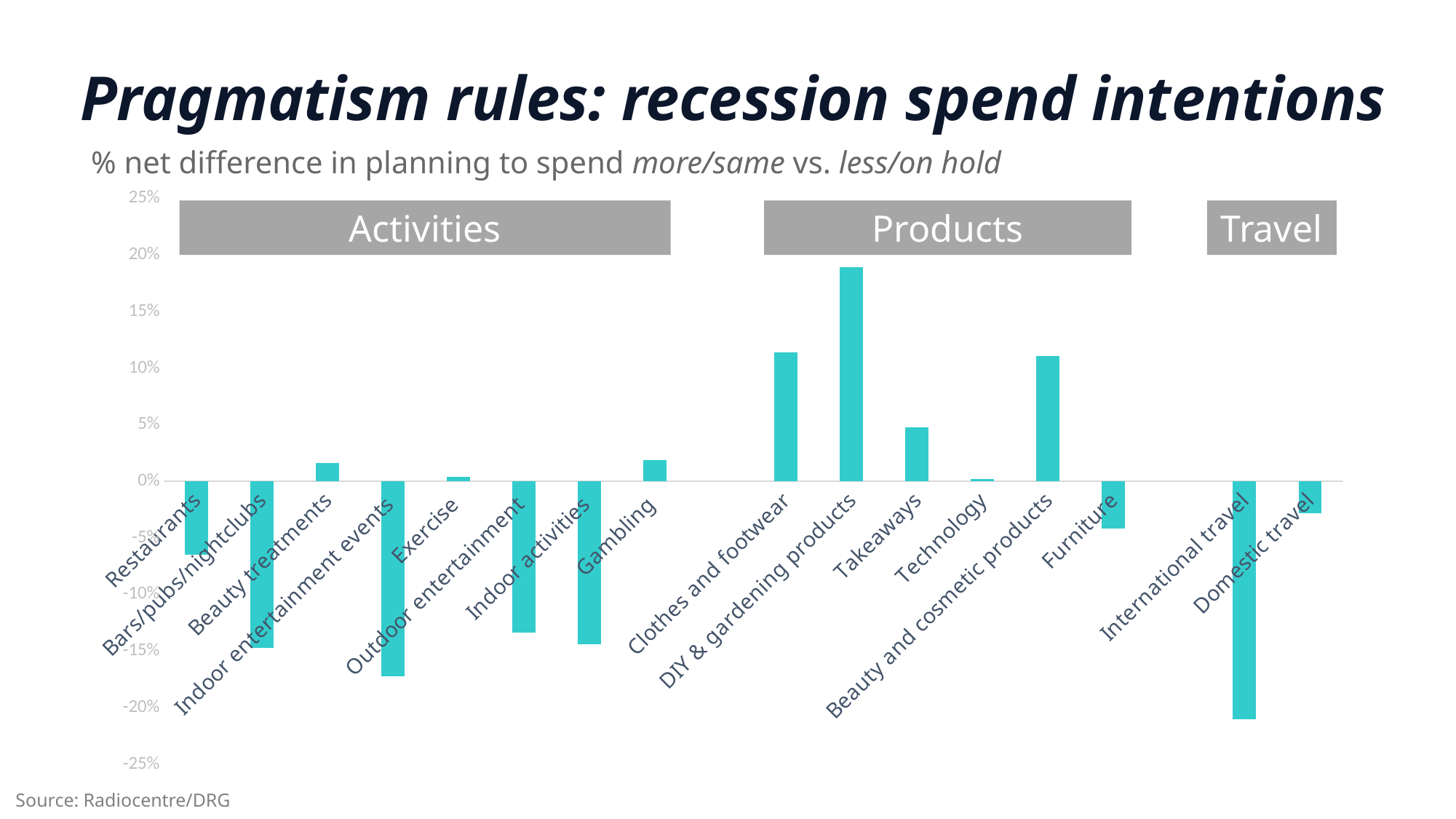
What are the three group headings shown above the bars? Activities, Products, Travel What source is cited for the chart? Radiocentre/DRG Which category has the highest value on the chart? DIY & gardening products Is the value for Indoor entertainment events greater or less than -15%? less Is the value for DIY & gardening products greater or less than 15%? greater Is the value for International travel greater or less than -20%? less Which is larger, the value for Gambling or the value for Exercise? Gambling Which is larger, the value for Takeaways or the value for Technology? Takeaways What kind of chart is shown on the slide? Bar chart Which category has the lowest value on the chart? International travel How many categories are plotted on the chart? 16